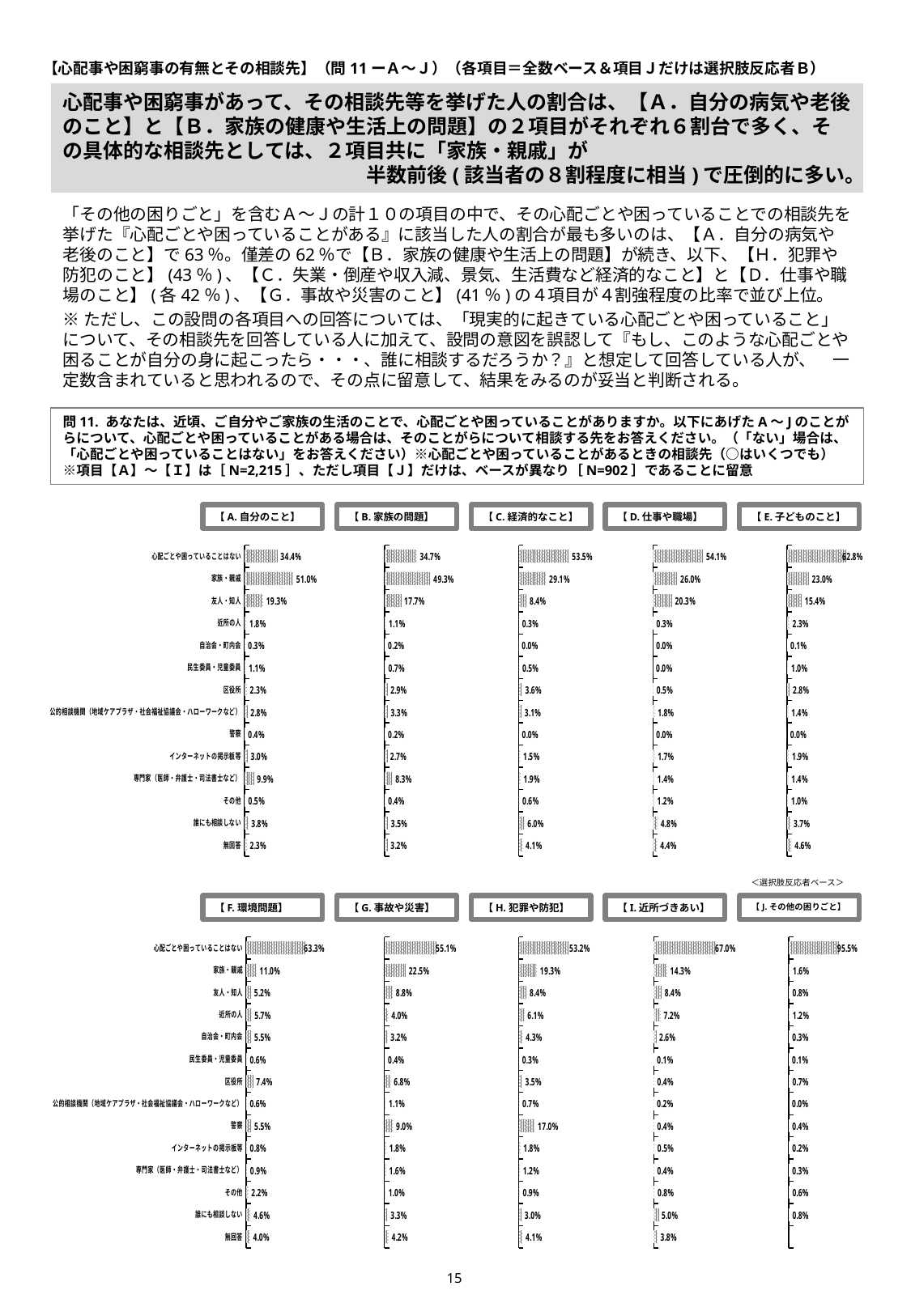
In the chart titled 【C. 経済的なこと】, what is the difference between 心配ごとや困っていることはない and 家族・親戚? 24.4% In the chart titled 【B. 家族の問題】, what is the value for 専門家（医師・弁護士・司法書士など）? 8.3% In the chart titled 【A. 自分のこと】, which category has the lowest value? 自治会・町内会 In the chart titled 【E. 子どものこと】, what is the value for 心配ごとや困っていることはない? 62.8% In the chart titled 【D. 仕事や職場】, which is larger: 家族・親戚 or 友人・知人? 家族・親戚 What kind of chart is used for 【I. 近所づきあい】? Bar chart How many categories are plotted in the chart titled 【F. 環境問題】? 14 How many separate bar charts (A to J) are shown on the slide? 10 In the chart titled 【J. その他の困りごと】, which category has the highest value? 心配ごとや困っていることはない In the chart titled 【H. 犯罪や防犯】, what is the value for 警察? 17.0% In the chart titled 【A. 自分のこと】, what is the value for 家族・親戚? 51.0% In the chart titled 【G. 事故や災害】, which is larger: 警察 or 区役所? 警察